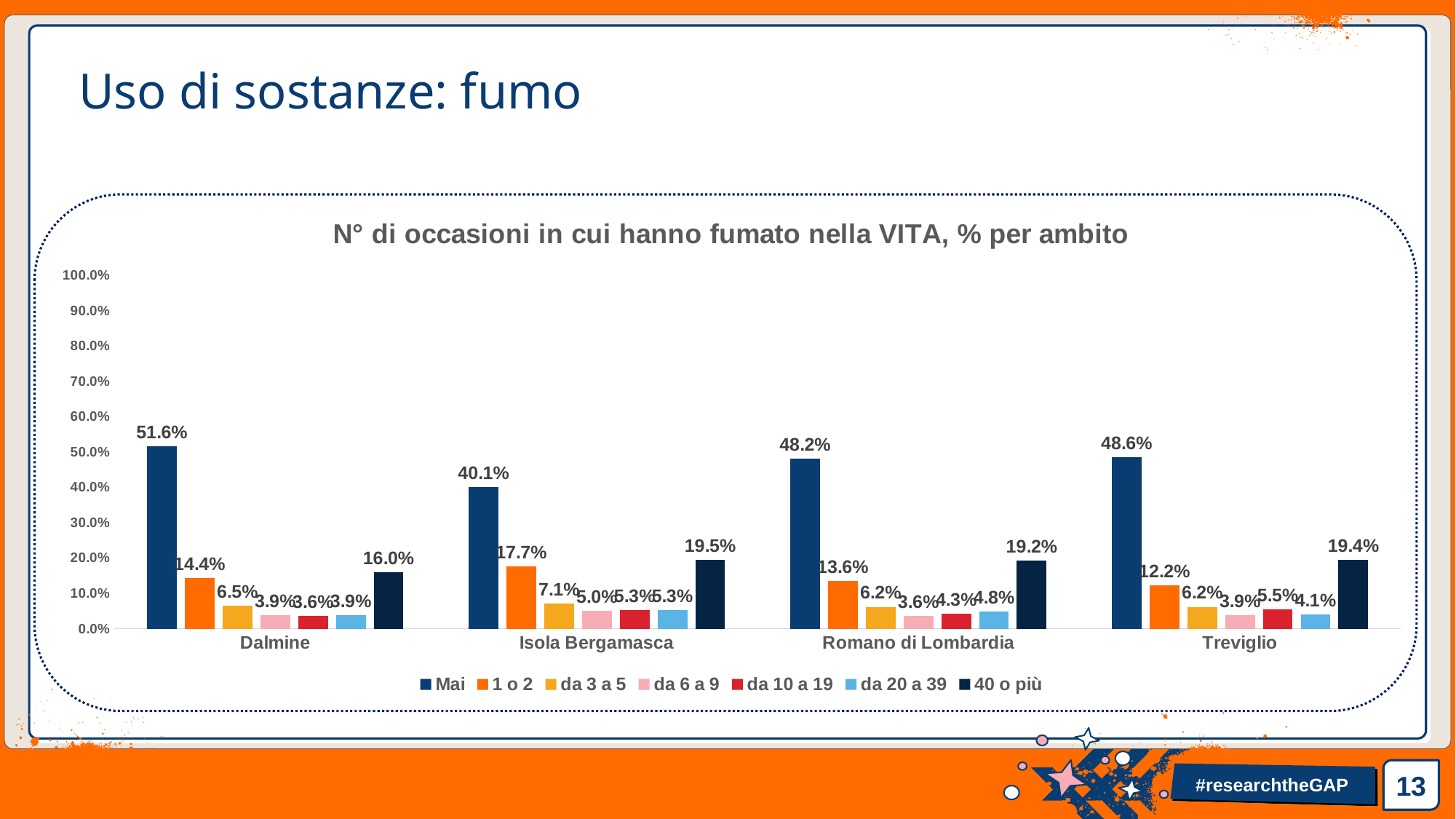
Which area has the lowest value for "Mai"? Isola Bergamasca What is the value for "40 o più" in Isola Bergamasca? 19.5% What is the title of the chart? N° di occasioni in cui hanno fumato nella VITA, % per ambito What is the value for "da 3 a 5" in Treviglio? 6.2% Which is larger: the "1 o 2" value for Isola Bergamasca or for Treviglio? Isola Bergamasca How many series does the legend list? 7 What is the value for "1 o 2" in Romano di Lombardia? 13.6% What is the value for "Mai" in Dalmine? 51.6% What kind of chart is shown on the slide? Bar chart What is the difference between the "Mai" values for Dalmine and Isola Bergamasca? 11.5% Which area has the highest value for "Mai"? Dalmine How many areas (categories) are shown on the x axis? 4